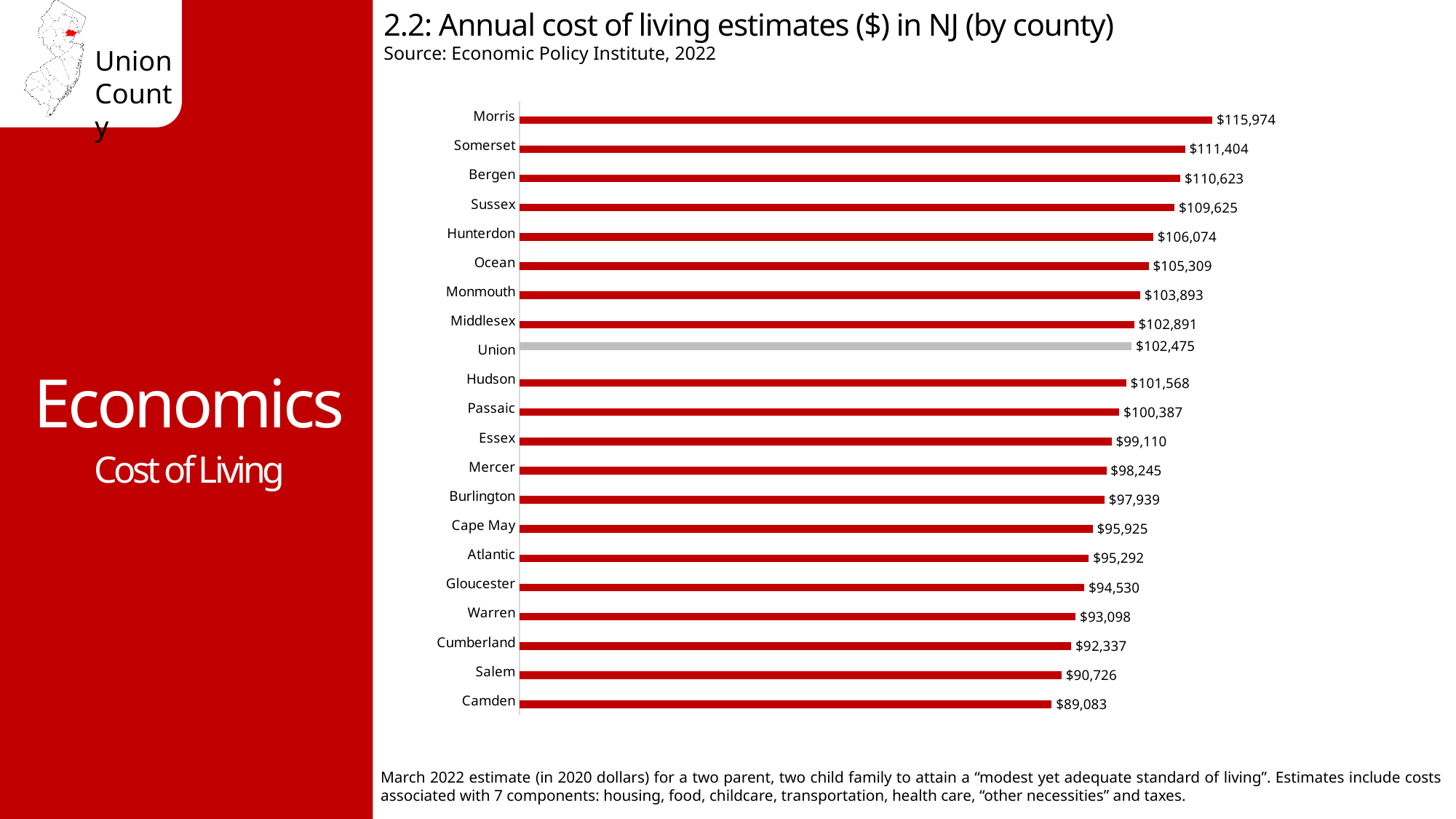
Which county's bar is shown in grey instead of red? Union What is the annual cost of living estimate for Cape May county? $95,925 What is the annual cost of living estimate for Union county? $102,475 How many counties are shown in the chart? 21 What is the difference between the cost of living estimates for Morris and Camden counties? $26,891 What is the difference between the cost of living estimates for Union and Hudson counties? $907 Which county has a higher cost of living estimate, Ocean or Monmouth? Ocean Which county has the lowest annual cost of living estimate? Camden What is the annual cost of living estimate for Morris county? $115,974 What kind of chart is used to show the annual cost of living estimates? Bar chart Which county has a higher cost of living estimate, Salem or Warren? Warren Which county has the highest annual cost of living estimate? Morris